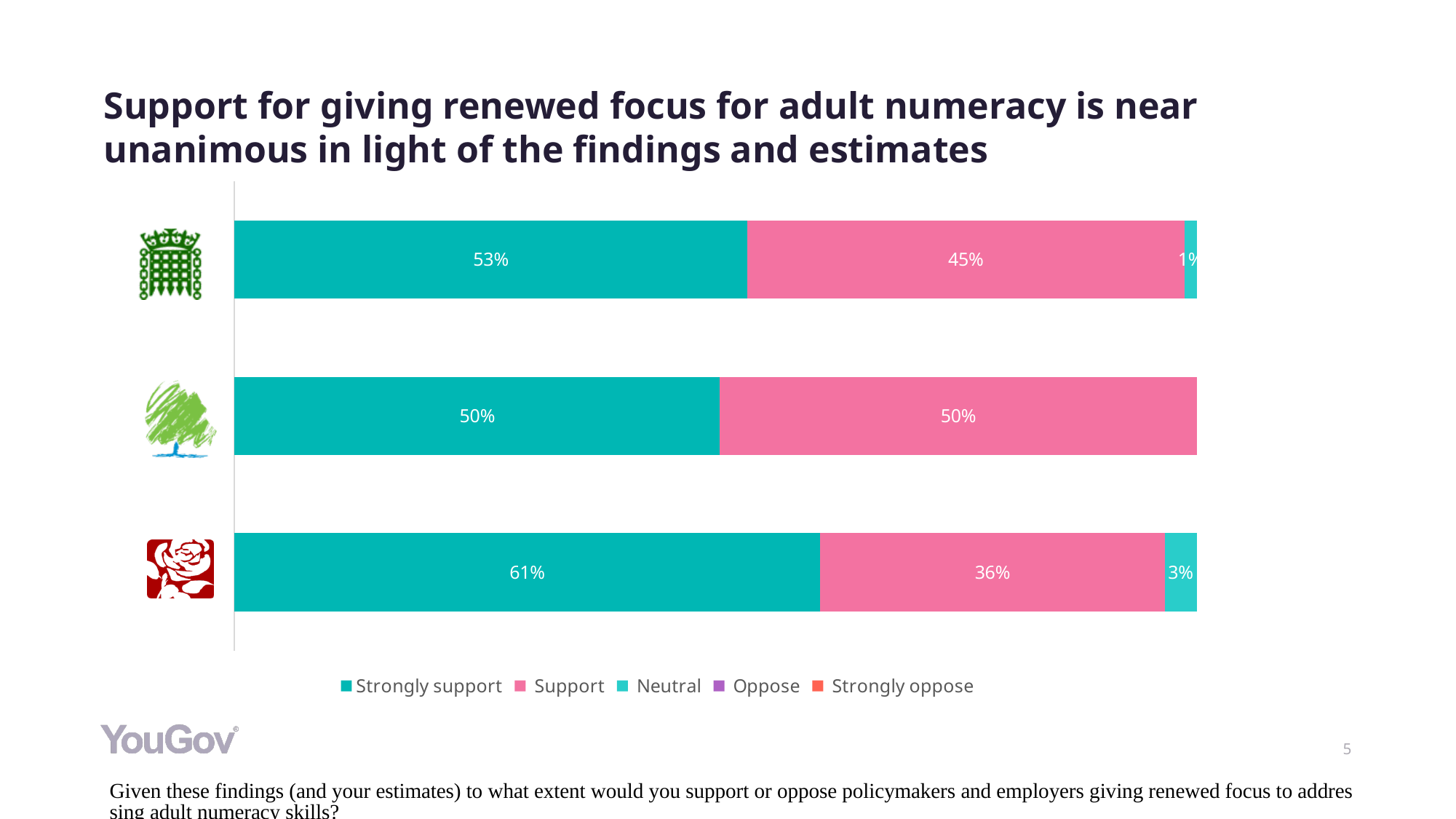
How many series does the legend list? 5 What is the Strongly support value for the top bar? 53% How many bars are shown in the chart? 3 What kind of chart is shown on the slide? Stacked bar chart Is the Strongly support value larger for the top bar or the middle bar? The top bar What is the Support value for the middle bar? 50% What is the combined Strongly support and Support total for the top bar? 98% Which bar has the highest Strongly support value? The bottom bar Which bar has the lowest Support value? The bottom bar What is the Neutral value for the bottom bar? 3% What is the difference between the Strongly support values of the bottom bar and the top bar? 8% What is the Support value for the bottom bar? 36%